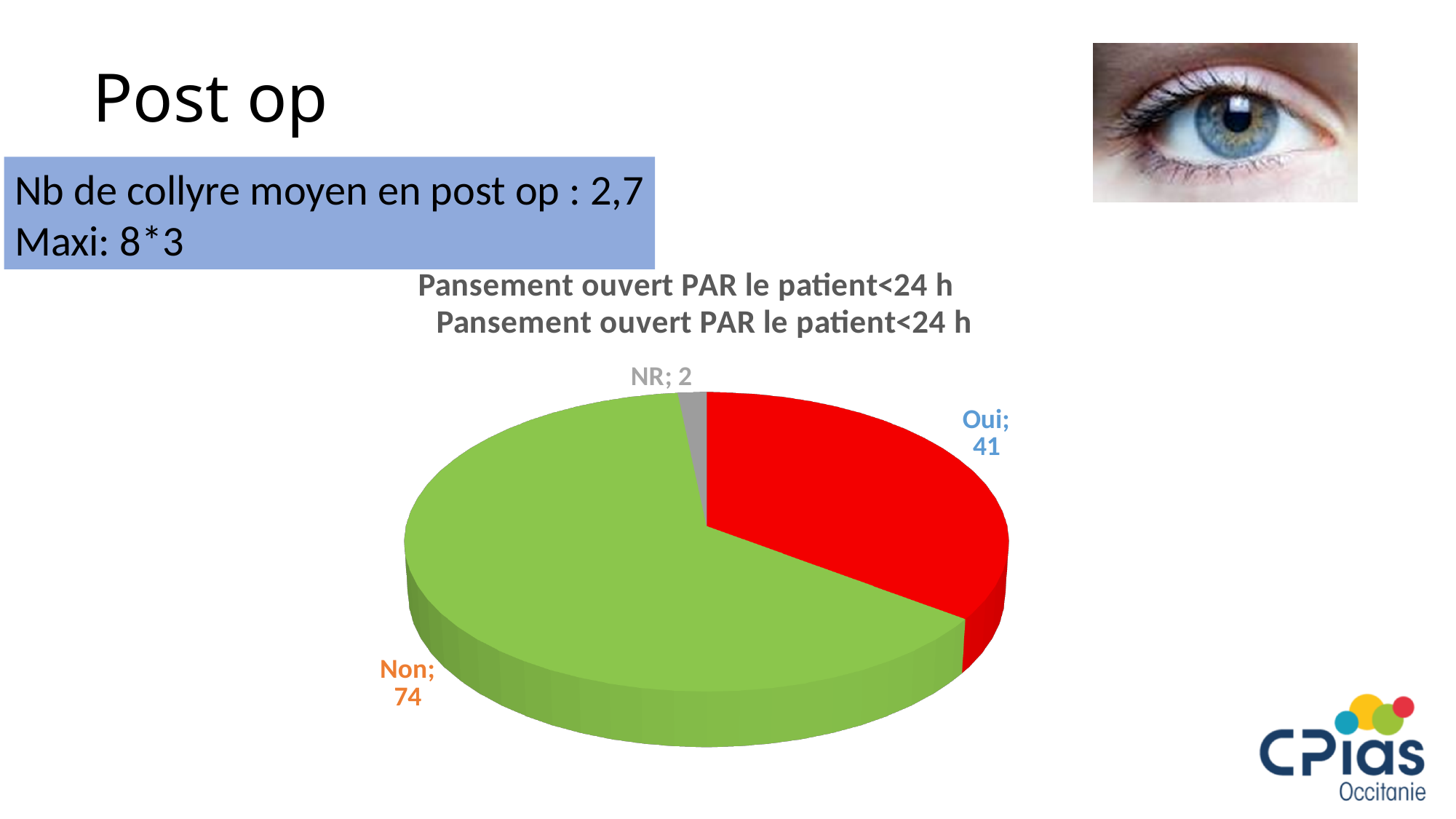
What colour is the 'Non' slice? green How many slices does the pie chart have? 3 Which is larger, the value for 'Oui' or the value for 'Non'? Non What is the title of the pie chart? Pansement ouvert PAR le patient<24 h Which category has the smallest slice of the pie? NR What is the value for the 'NR' slice? 2 What is the value for the 'Oui' slice? 41 What is the difference between the 'Non' and 'Oui' values? 33 What is the total of all slices in the pie chart? 117 What type of chart is shown on the slide? pie chart What is the value for the 'Non' slice? 74 Which category has the largest slice of the pie? Non